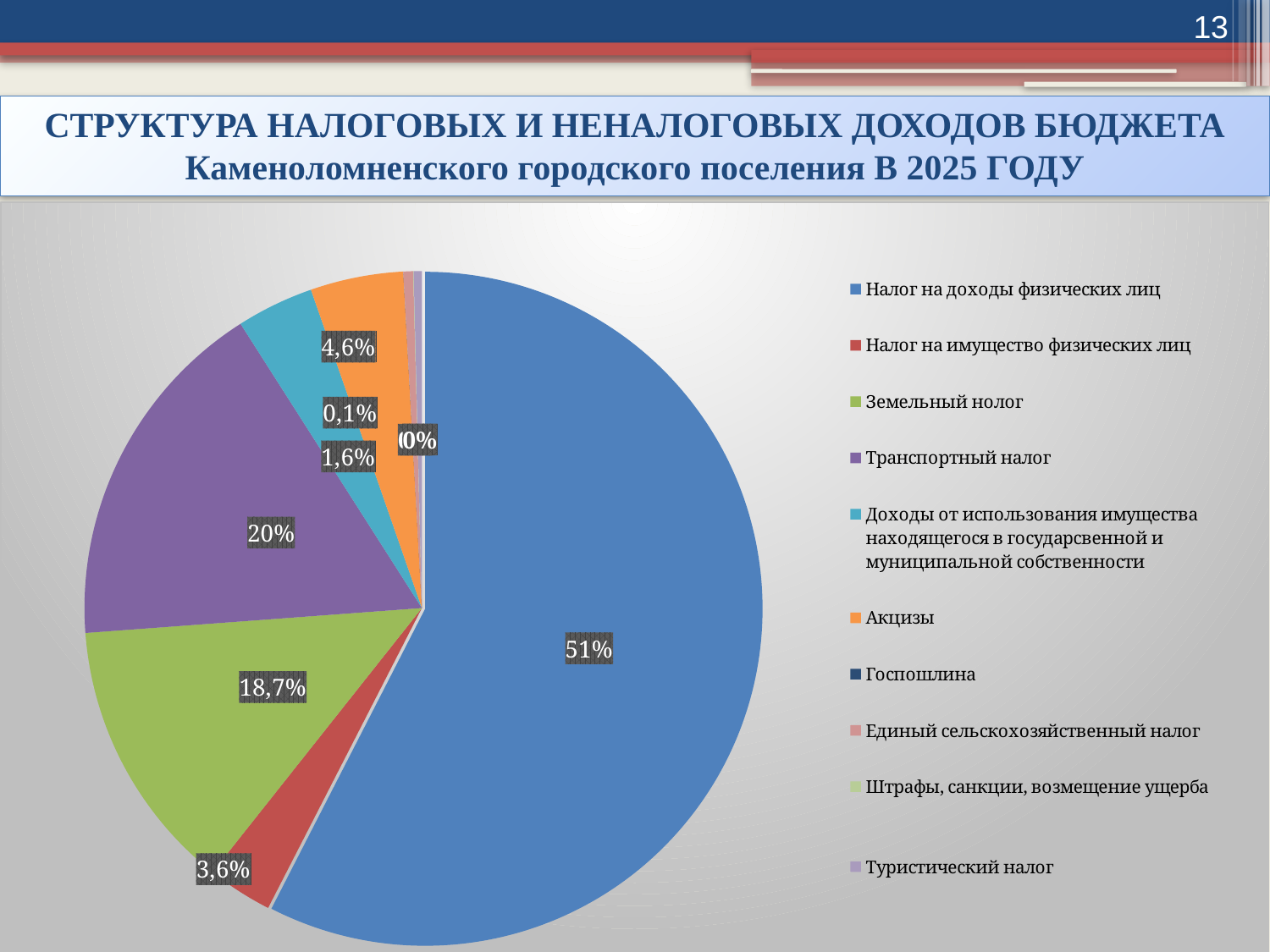
What is the value shown for Земельный нолог? 18,7% What kind of chart is shown on the slide? pie chart What colour is the slice for Налог на доходы физических лиц? blue What is the value shown for Доходы от использования имущества находящегося в государсвенной и муниципальной собственности? 1,6% Which category has the largest slice of the pie? Налог на доходы физических лиц How many categories does the legend list? 10 What is the value shown for Налог на имущество физических лиц? 3,6% Which is larger, Транспортный налог or Земельный нолог? Транспортный налог What is the value shown for Транспортный налог? 20% What is the value shown for Акцизы? 4,6% What share of the budget revenue does Налог на доходы физических лиц account for? 51% What is the difference between the shares of Налог на доходы физических лиц and Транспортный налог? 31%